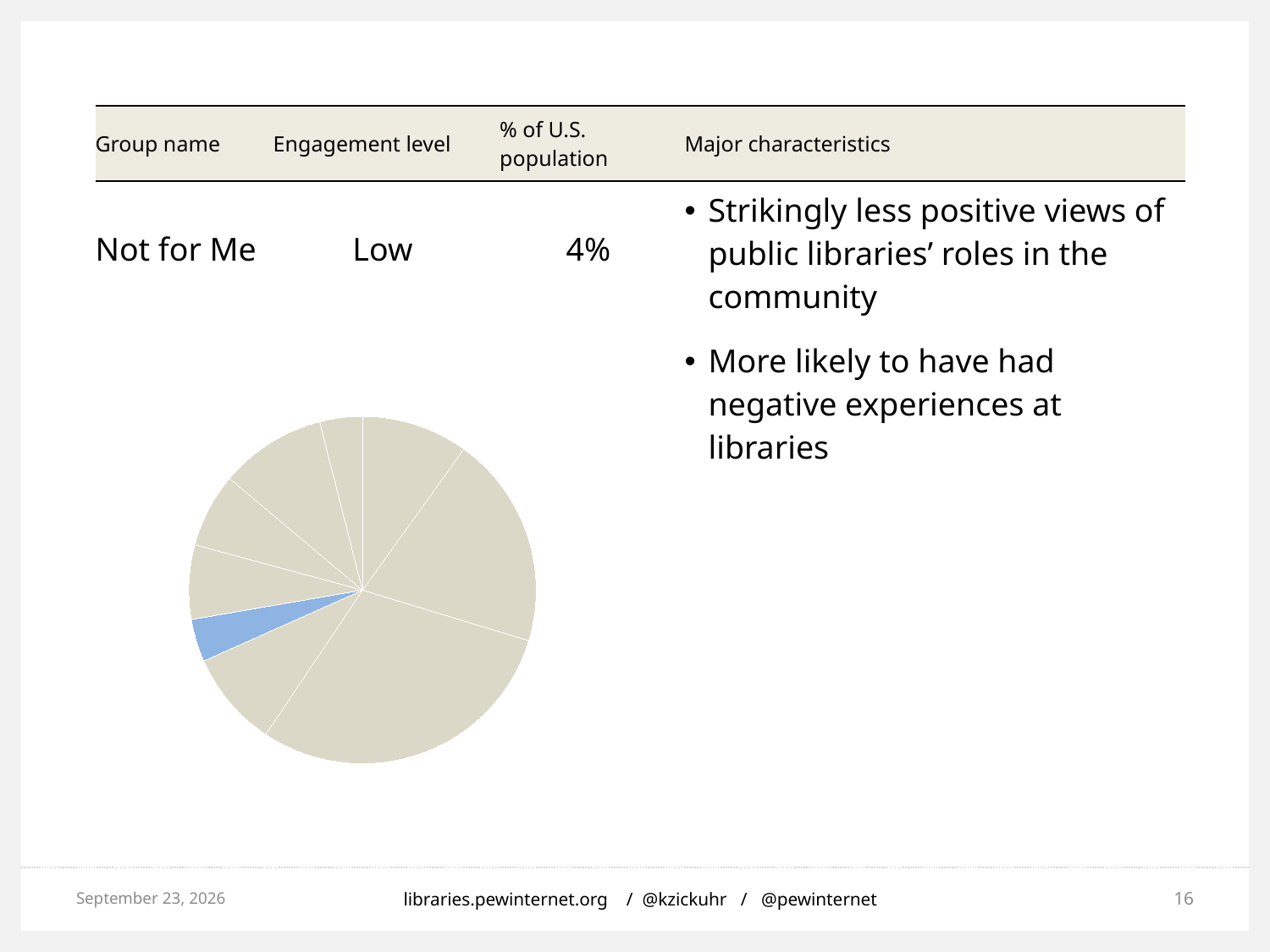
What colour is the highlighted slice of the pie chart? blue What kind of chart is shown on the slide? pie chart What share of the pie does the highlighted blue slice represent? 4% Which group does the highlighted slice of the pie chart represent? Not for Me